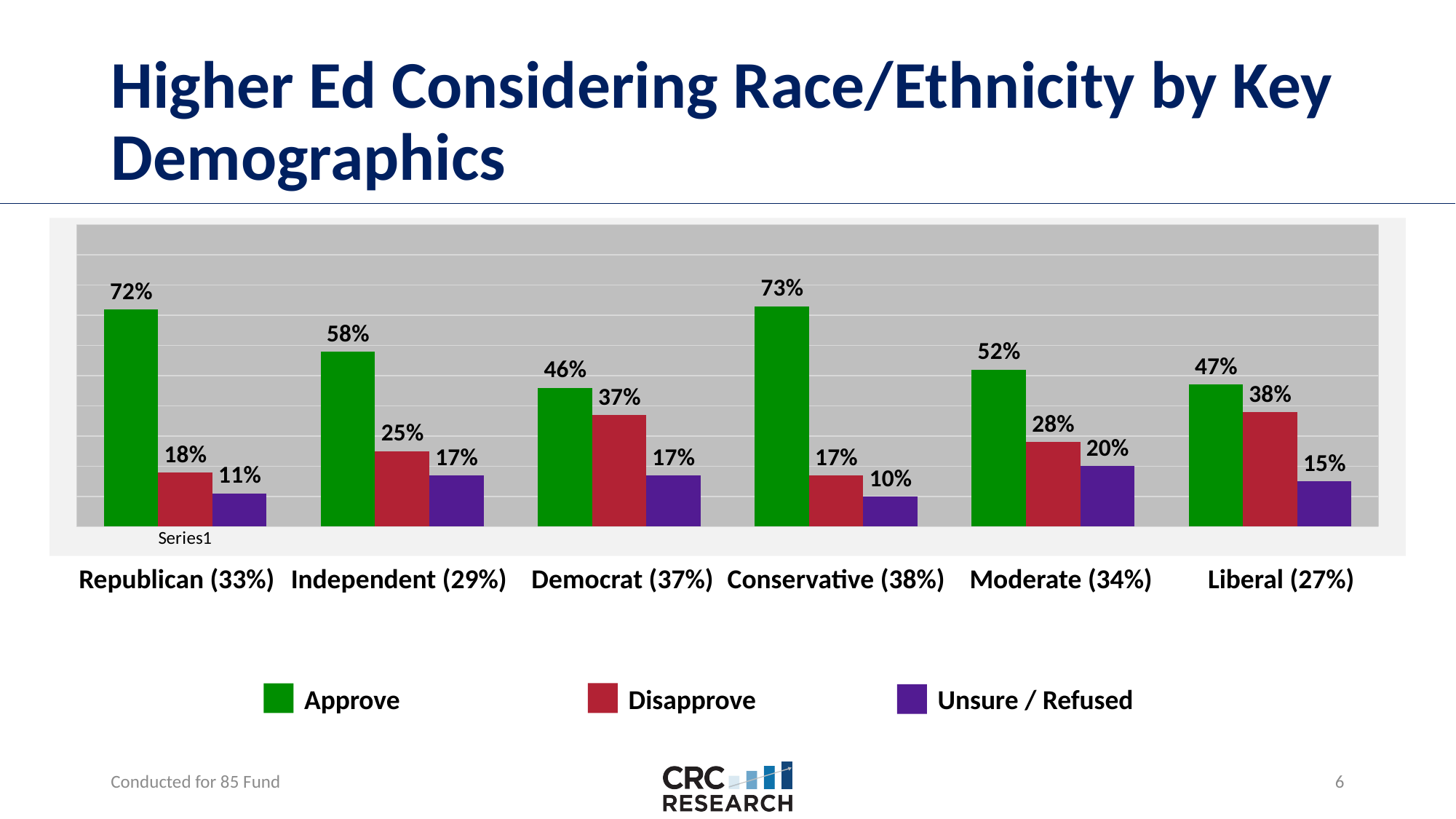
What kind of chart is shown on the slide? Bar chart Which colour represents the Disapprove series in the legend? Red What is the Unsure / Refused value for Moderate (34%)? 20% What is the Disapprove value for Democrat (37%)? 37% What is the Approve value for Republican (33%)? 72% How many categories are shown on the x axis? 6 Which category has the highest Approve value? Conservative (38%) What is the difference between the Approve values for Republican (33%) and Democrat (37%)? 26% How many series does the legend list? 3 What is the total of the Approve and Disapprove values for Liberal (27%)? 85% Which category has the lowest Unsure / Refused value? Conservative (38%) Which is larger, the Disapprove value for Liberal (27%) or for Independent (29%)? Liberal (27%)